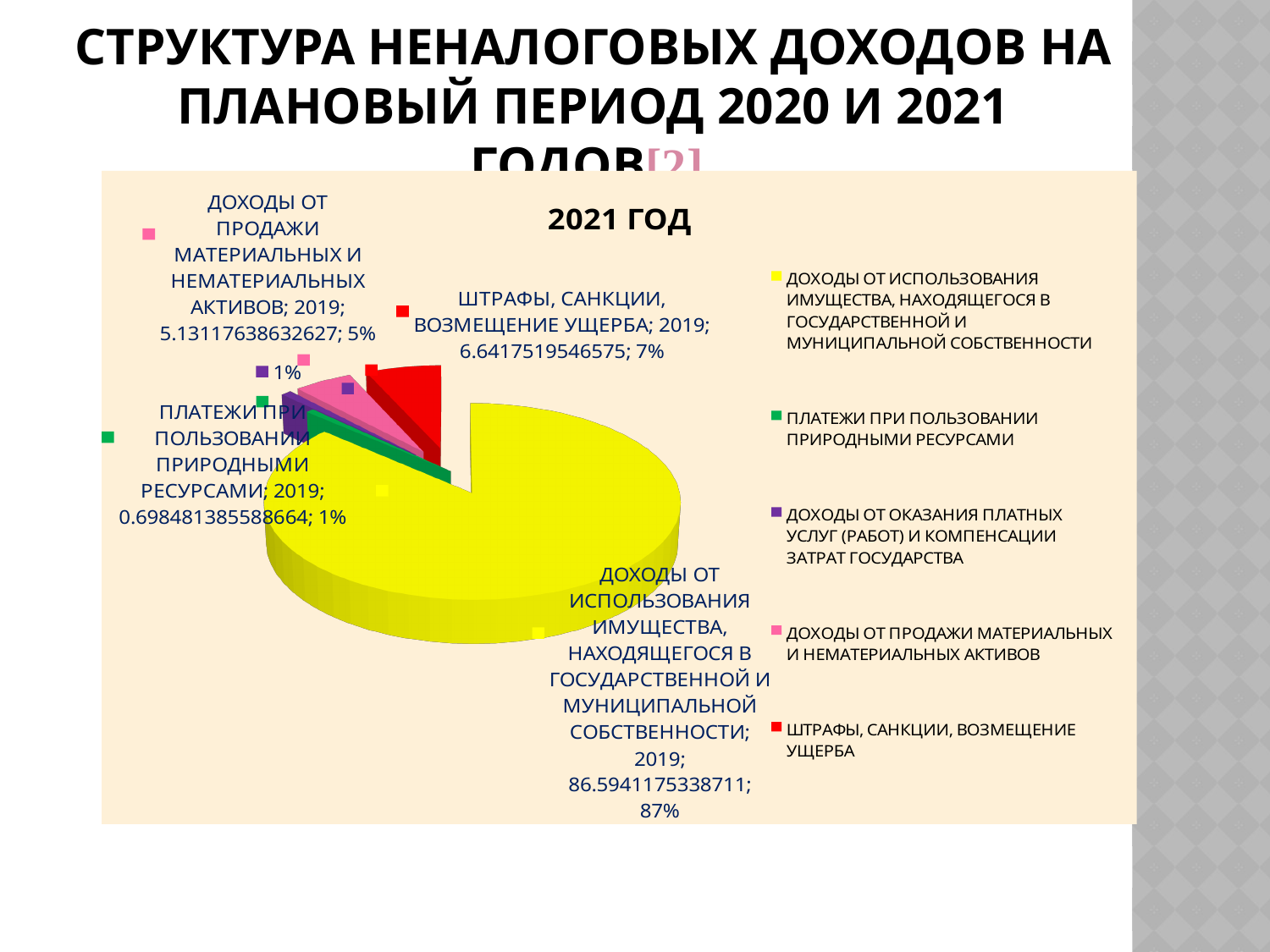
What share of the pie does ПЛАТЕЖИ ПРИ ПОЛЬЗОВАНИИ ПРИРОДНЫМИ РЕСУРСАМИ have? 1% What value is printed in the data label for ДОХОДЫ ОТ ПРОДАЖИ МАТЕРИАЛЬНЫХ И НЕМАТЕРИАЛЬНЫХ АКТИВОВ? 5.13117638632627 What kind of chart is shown on the slide? pie chart What is the title of the chart? 2021 ГОД Which slice is larger: ШТРАФЫ, САНКЦИИ, ВОЗМЕЩЕНИЕ УЩЕРБА or ДОХОДЫ ОТ ПРОДАЖИ МАТЕРИАЛЬНЫХ И НЕМАТЕРИАЛЬНЫХ АКТИВОВ? ШТРАФЫ, САНКЦИИ, ВОЗМЕЩЕНИЕ УЩЕРБА What share of the pie does ДОХОДЫ ОТ ИСПОЛЬЗОВАНИЯ ИМУЩЕСТВА, НАХОДЯЩЕГОСЯ В ГОСУДАРСТВЕННОЙ И МУНИЦИПАЛЬНОЙ СОБСТВЕННОСТИ have? 87% What value is printed in the data label for ШТРАФЫ, САНКЦИИ, ВОЗМЕЩЕНИЕ УЩЕРБА? 6.6417519546575 What share of the pie does ДОХОДЫ ОТ ПРОДАЖИ МАТЕРИАЛЬНЫХ И НЕМАТЕРИАЛЬНЫХ АКТИВОВ have? 5% How many slices does the pie chart have? 5 Which category has the largest slice of the pie? ДОХОДЫ ОТ ИСПОЛЬЗОВАНИЯ ИМУЩЕСТВА, НАХОДЯЩЕГОСЯ В ГОСУДАРСТВЕННОЙ И МУНИЦИПАЛЬНОЙ СОБСТВЕННОСТИ By how many percentage points does the share of ДОХОДЫ ОТ ИСПОЛЬЗОВАНИЯ ИМУЩЕСТВА exceed the share of ШТРАФЫ, САНКЦИИ, ВОЗМЕЩЕНИЕ УЩЕРБА? 80%